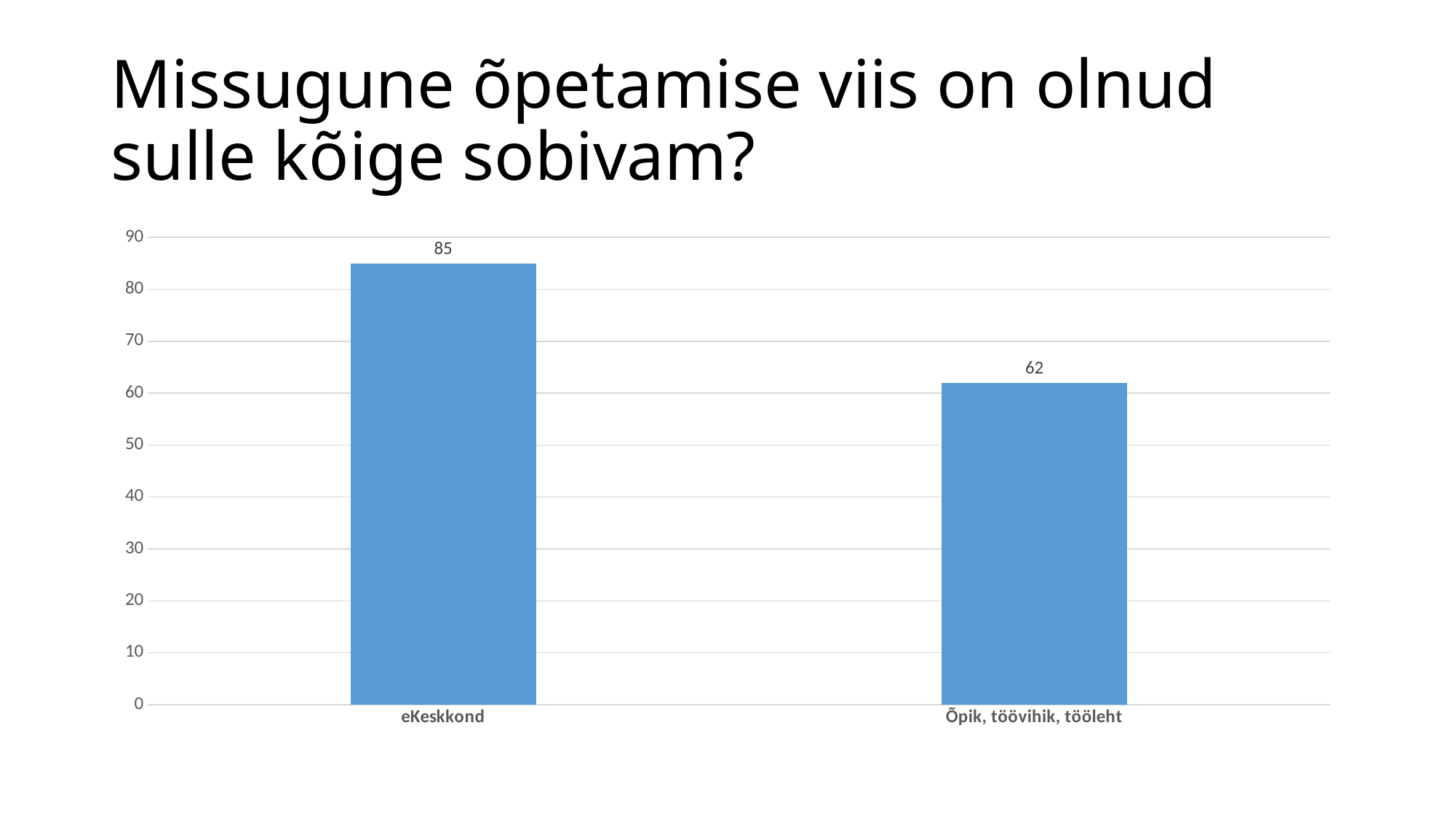
What is the difference between the values for eKeskkond and Õpik, töövihik, tööleht? 23 What is the value for Õpik, töövihik, tööleht? 62 Is the value for eKeskkond greater or less than 80? greater What is the value for eKeskkond? 85 Which is larger, the value for eKeskkond or the value for Õpik, töövihik, tööleht? eKeskkond Which category has the lowest value? Õpik, töövihik, tööleht What is the title of the slide? Missugune õpetamise viis on olnud sulle kõige sobivam? How many categories are shown on the chart? 2 Which category has the highest value? eKeskkond What kind of chart is shown on the slide? bar chart What is the highest value shown on the vertical axis? 90 Is the value for Õpik, töövihik, tööleht greater or less than 70? less